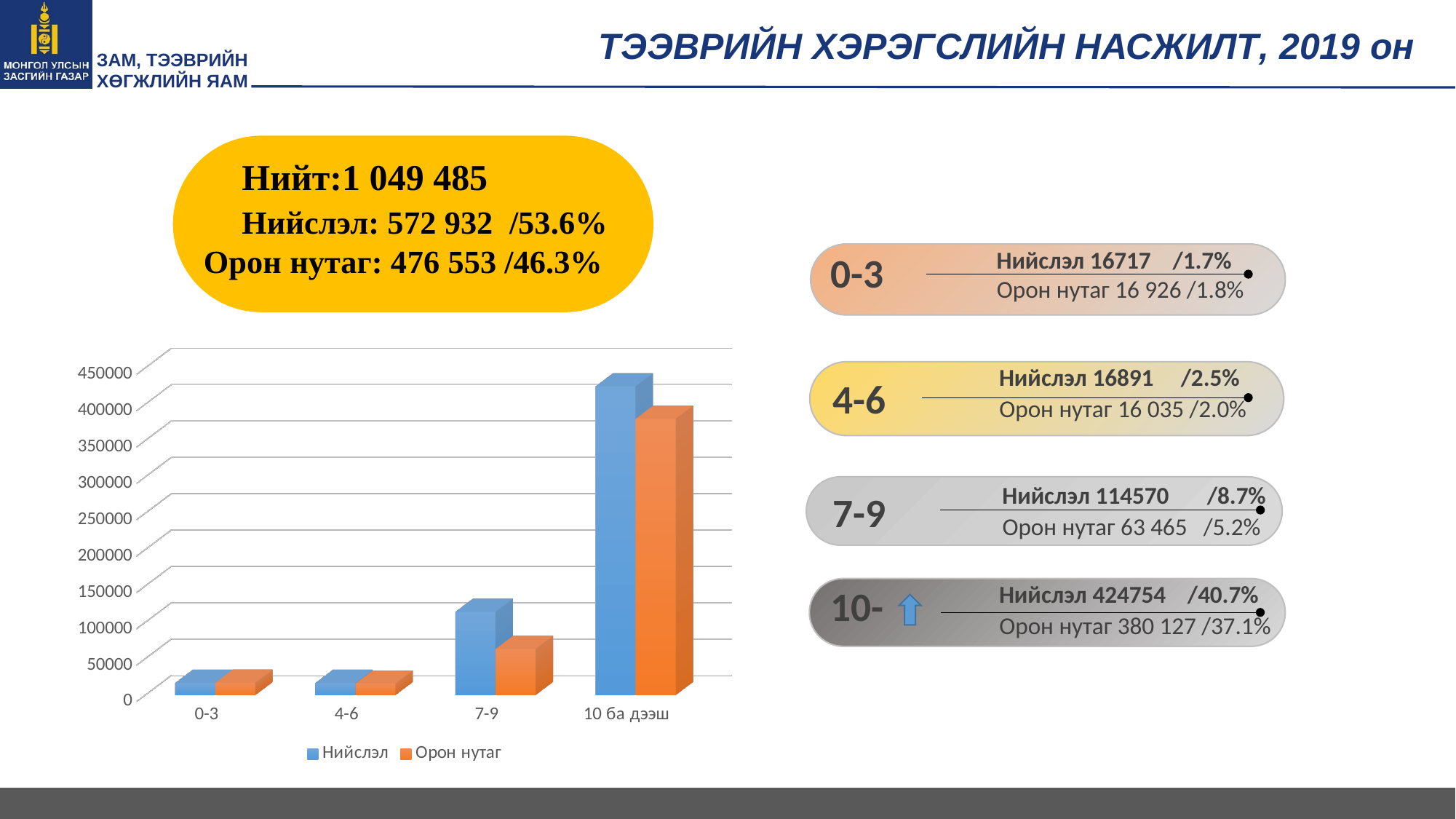
Is the value for Орон нутаг in the 10 ба дээш category greater or less than 400000? less Is the value for Нийслэл in the 7-9 category greater or less than 100000? greater Is the value for Нийслэл in the 10 ба дээш category greater or less than 400000? greater How many age categories are shown on the x axis of the chart? 4 In the 7-9 category, which series has the larger value, Нийслэл or Орон нутаг? Нийслэл Do the Нийслэл values rise or fall from the 0-3 category to the 10 ба дээш category? rise In the 10 ба дээш category, which series has the larger value, Нийслэл or Орон нутаг? Нийслэл Which colour represents the Орон нутаг series in the chart? orange What kind of chart is shown on the slide? bar chart Which category has the highest value for Нийслэл in the chart? 10 ба дээш How many series does the chart legend list? 2